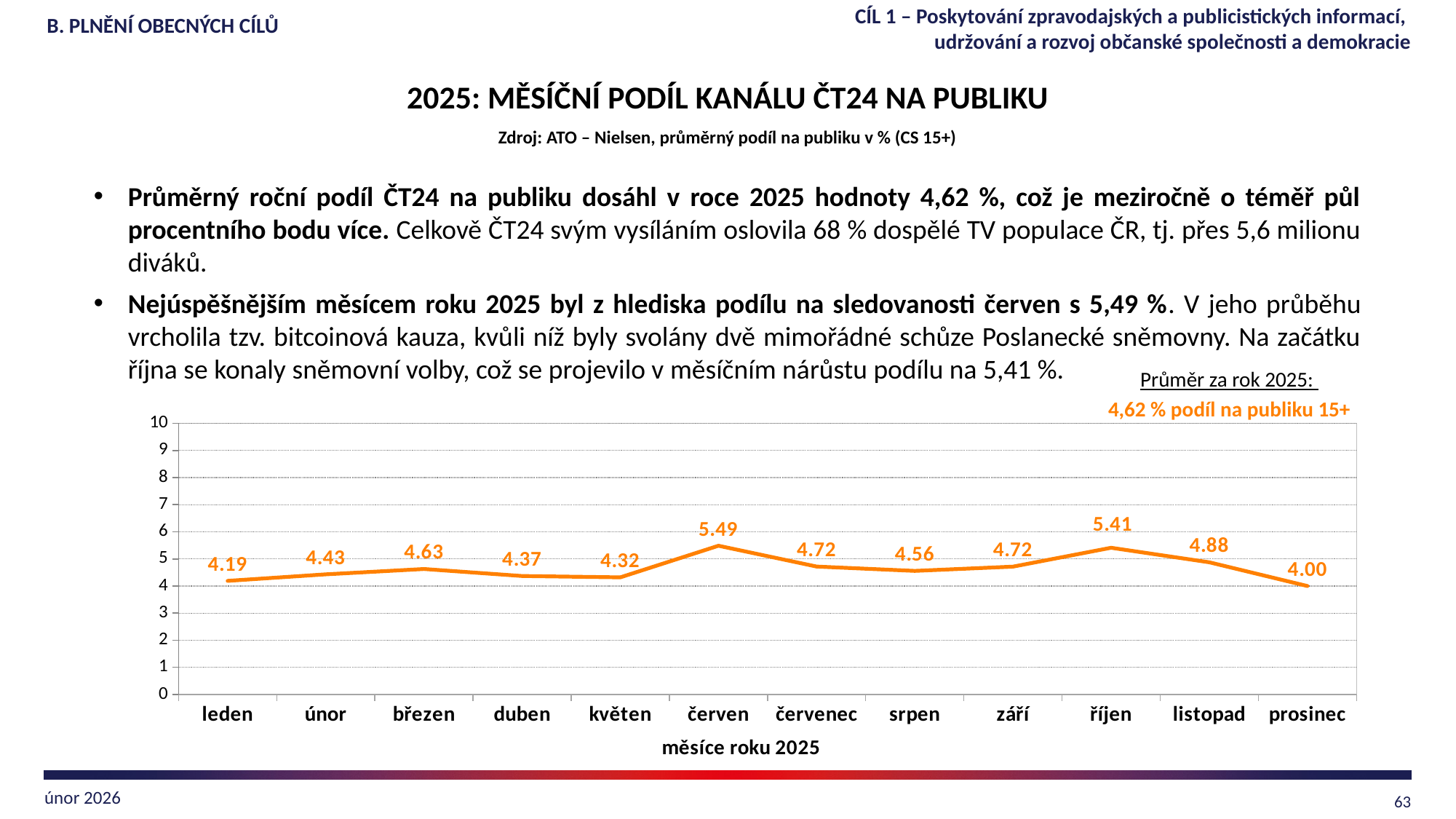
What is the value for prosinec (December) in the chart? 4.00 What is the difference between the values for červen and prosinec? 1.49 Which month has the highest value in the chart? červen How many months are plotted on the x axis of the chart? 12 What kind of chart is shown on the slide? line chart Which is larger, the value for říjen or the value for listopad? říjen What is the x-axis title of the chart? měsíce roku 2025 What is the value for leden (January) in the chart? 4.19 Do the values rise or fall from říjen to prosinec? fall What is the value for červen (June) in the chart? 5.49 Which month has the lowest value in the chart? prosinec Is the value for březen greater or less than 5? less